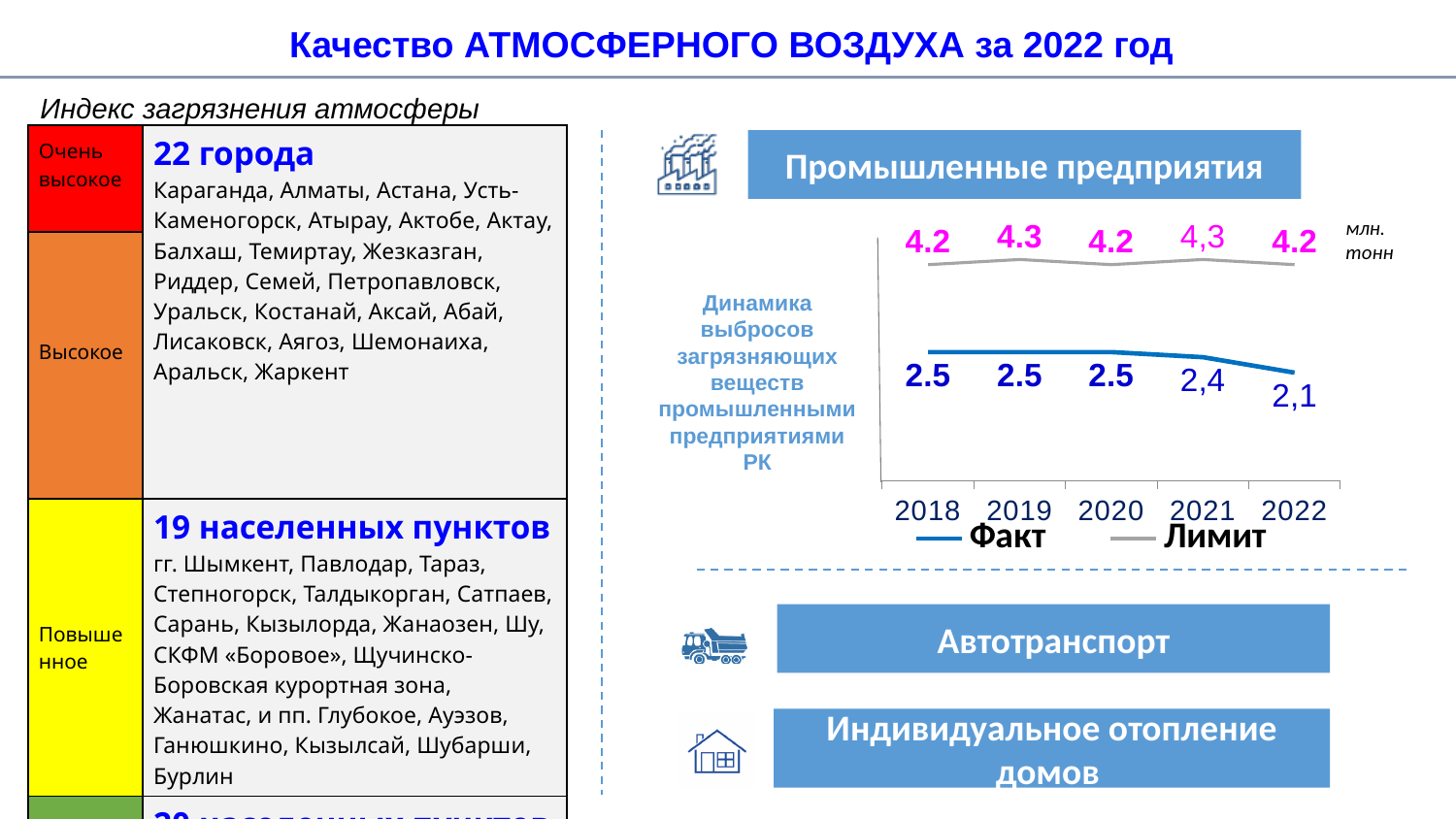
What is the Лимит value for 2019 on the emissions chart? 4.3 Does the Факт series rise or fall from 2020 to 2022 on the emissions chart? fall In which year is the Факт value lowest on the emissions chart? 2022 What type of chart is used to show the dynamics of pollutant emissions by industrial enterprises? line chart How many years are shown on the x axis of the emissions chart? 5 What is the Лимит value for 2021 on the emissions chart? 4,3 What is the Факт value for 2018 on the emissions chart? 2.5 How many series does the legend of the emissions chart list? 2 What is the difference between the Лимит and Факт values in 2022 on the emissions chart? 2.1 What are the two series named in the legend of the emissions chart? Факт and Лимит Which series is higher in 2020 on the emissions chart, Факт or Лимит? Лимит What is the Факт value for 2022 on the emissions chart? 2,1